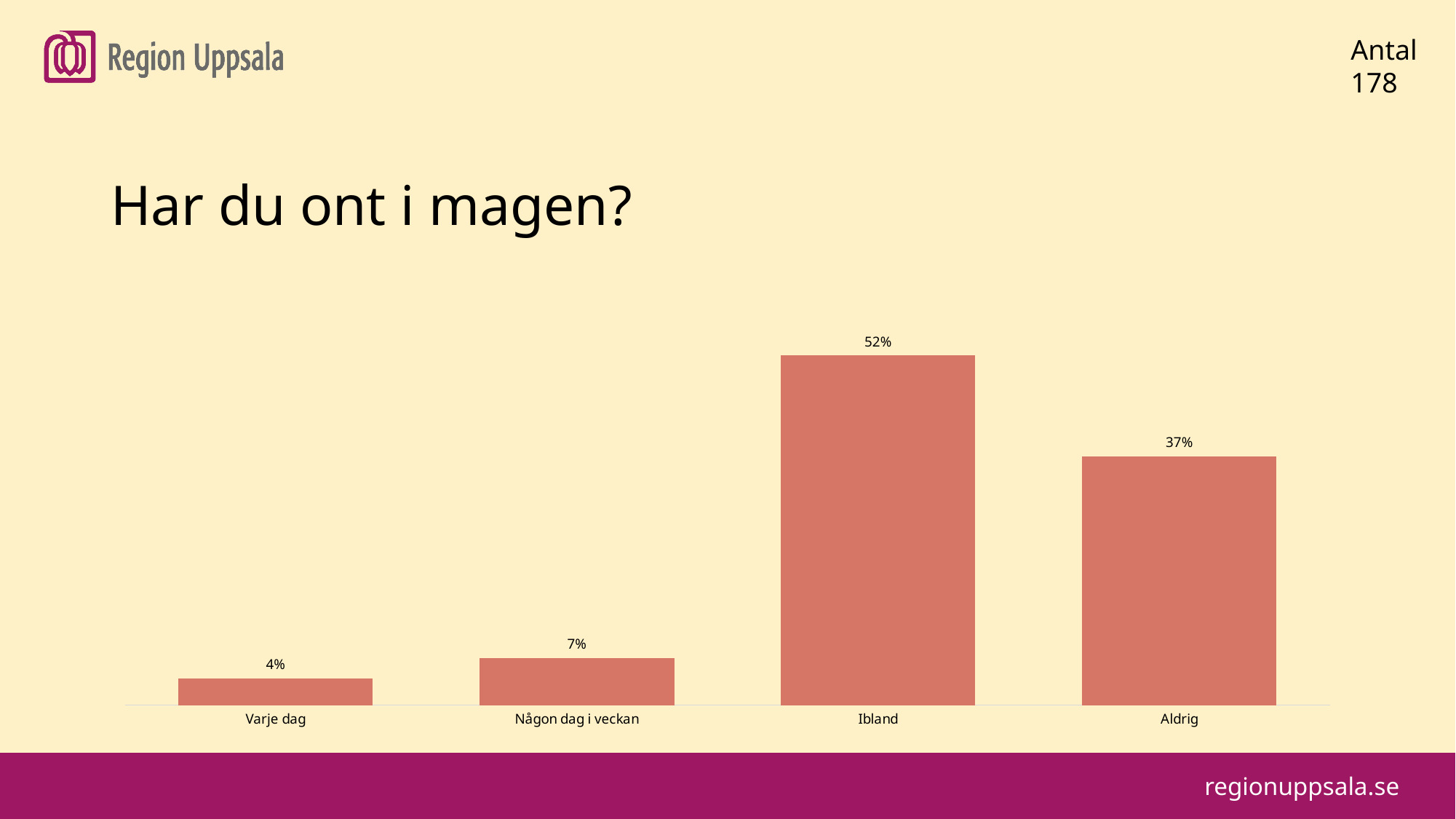
What is the value for Aldrig? 37% What is the value for Ibland? 52% Which is larger, the value for Aldrig or the value for Någon dag i veckan? Aldrig What is the difference between the values for Ibland and Aldrig? 15% What is the difference between the values for Någon dag i veckan and Varje dag? 3% Which category has the lowest value? Varje dag What is the value for Varje dag? 4% How many categories are shown in the chart? 4 Which category has the highest value? Ibland What kind of chart is shown on the slide? Bar chart What is the value for Någon dag i veckan? 7% What is the title of the slide above the chart? Har du ont i magen?